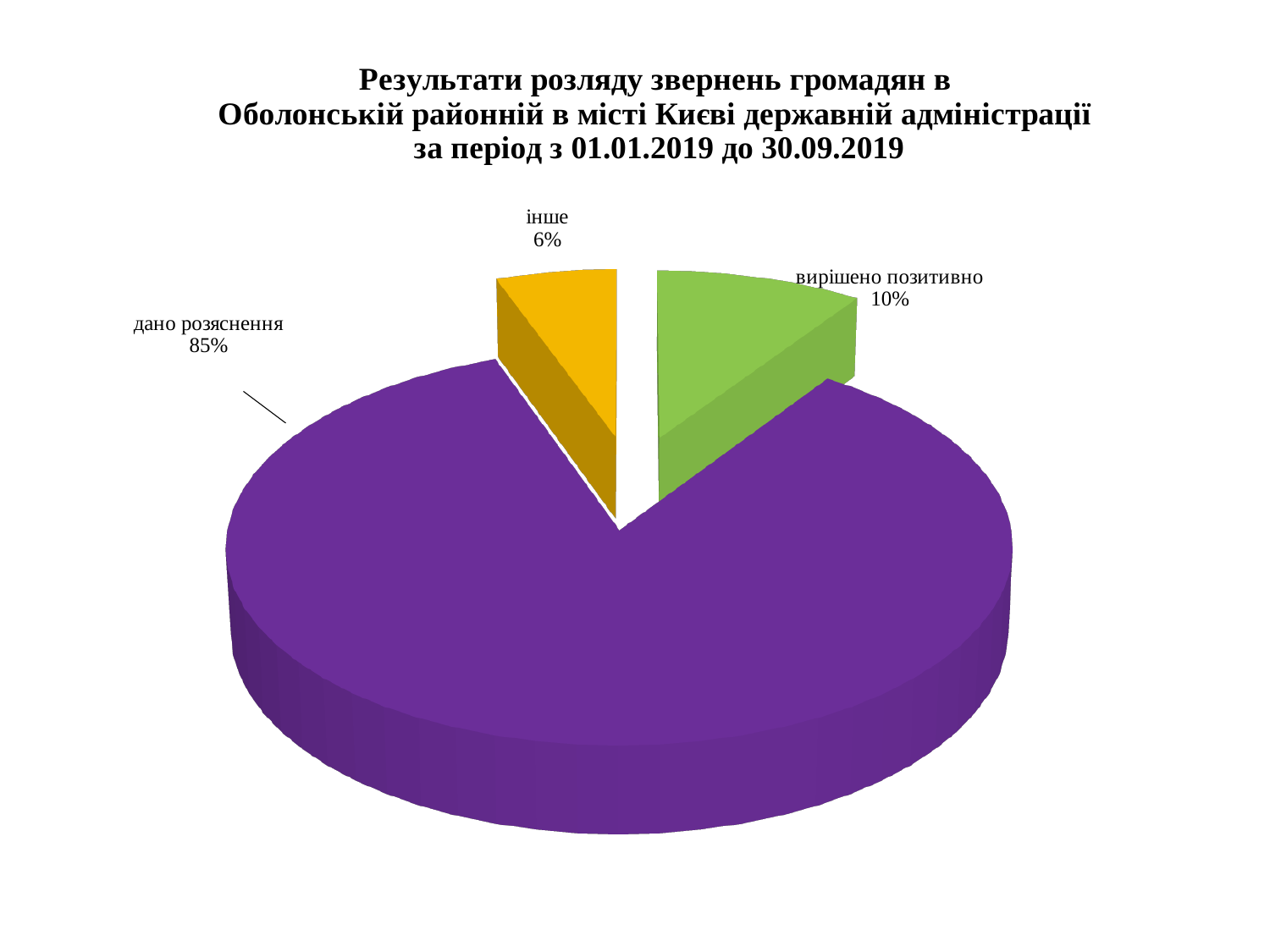
Which is larger, the share for "вирішено позитивно" or the share for "інше"? вирішено позитивно What colour is the slice for "дано розяснення"? purple What share of the pie does "вирішено позитивно" represent? 10% What share of the pie does "інше" represent? 6% What kind of chart is shown on the slide? pie chart What period does the chart title say the data covers? з 01.01.2019 до 30.09.2019 Which category has the smallest slice of the pie? інше What is the difference in percentage points between "вирішено позитивно" and "інше"? 4 How many slices does the pie chart have? 3 What is the difference in percentage points between "дано розяснення" and "вирішено позитивно"? 75 Which category has the largest slice of the pie? дано розяснення What share of the pie does "дано розяснення" represent? 85%